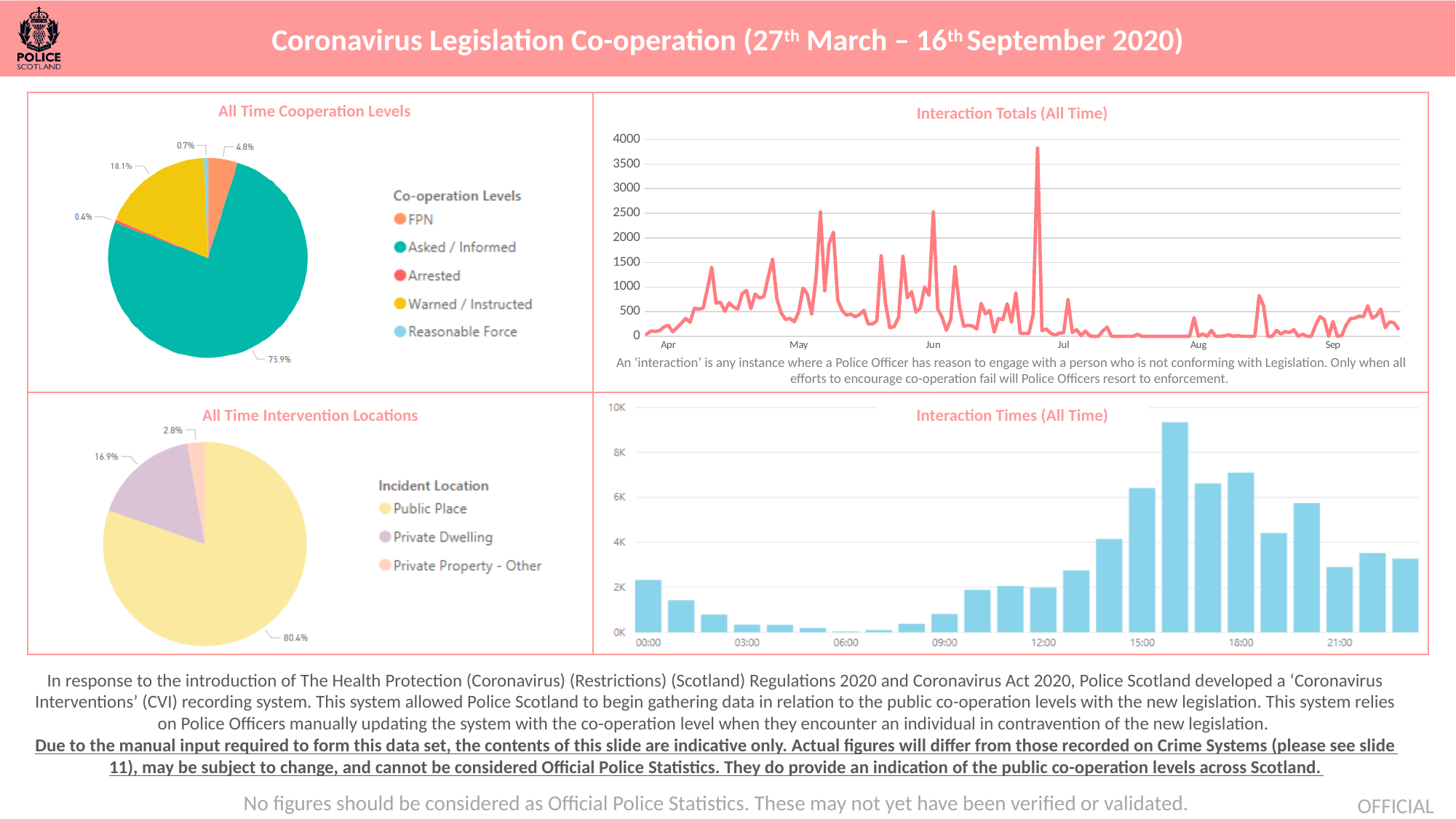
In the All Time Cooperation Levels chart, what percentage is Warned / Instructed? 18.1% In the All Time Cooperation Levels chart, what is the difference in percentage points between Warned / Instructed and FPN? 13.3 In the All Time Intervention Locations chart, what percentage is Private Dwelling? 16.9% In the All Time Cooperation Levels chart, which co-operation level has the smallest share? Arrested In the Interaction Totals (All Time) chart, is the highest peak greater or less than 3500? greater In the Interaction Times (All Time) chart, is the value for the tallest bar (around 16:00) greater or less than 8K? greater In the All Time Cooperation Levels chart, how many co-operation levels does the legend list? 5 In the All Time Intervention Locations chart, which incident location has the largest share? Public Place What kind of chart is Interaction Totals (All Time)? Line chart In the All Time Cooperation Levels chart, what percentage is Asked / Informed? 75.9% In the All Time Intervention Locations chart, what is the difference in percentage points between Public Place and Private Dwelling? 63.5 What kind of chart is Interaction Times (All Time)? Bar chart